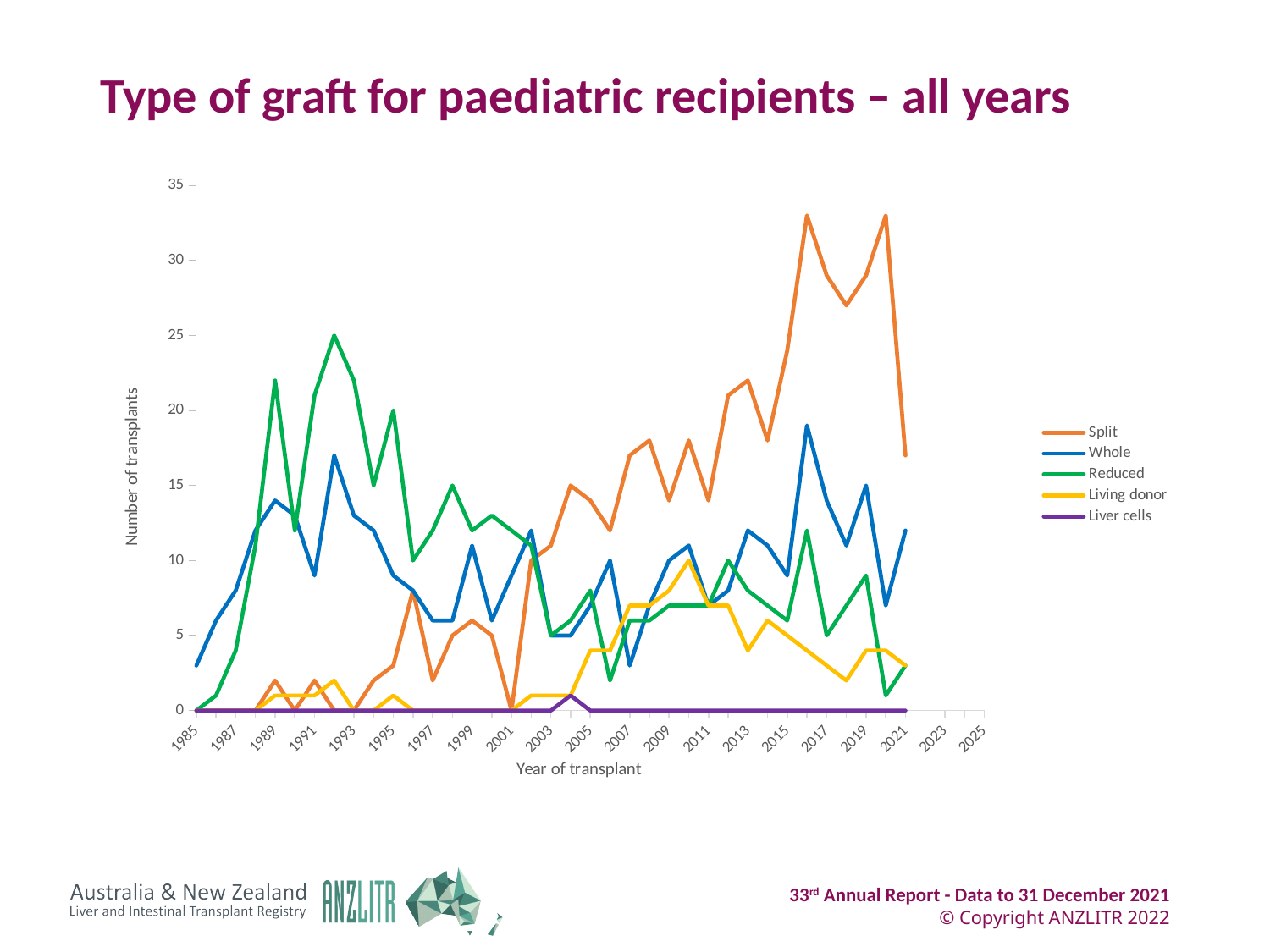
In 2021, which is larger, Whole or Reduced? Whole Is the value for Reduced in 1989 greater or less than 20? greater Does the Split series generally rise or fall between 2011 and 2017? rise In 2017, which is larger, Split or Whole? Split Is the value for Whole in 1985 greater or less than 5? less Which series is shown in purple in the legend? Liver cells Which series stays lowest across the whole period? Liver cells Which series reaches the highest number of transplants in any year? Split How many series does the legend list? 5 What kind of chart is shown on the slide? line chart What is the title of the chart? Type of graft for paediatric recipients – all years